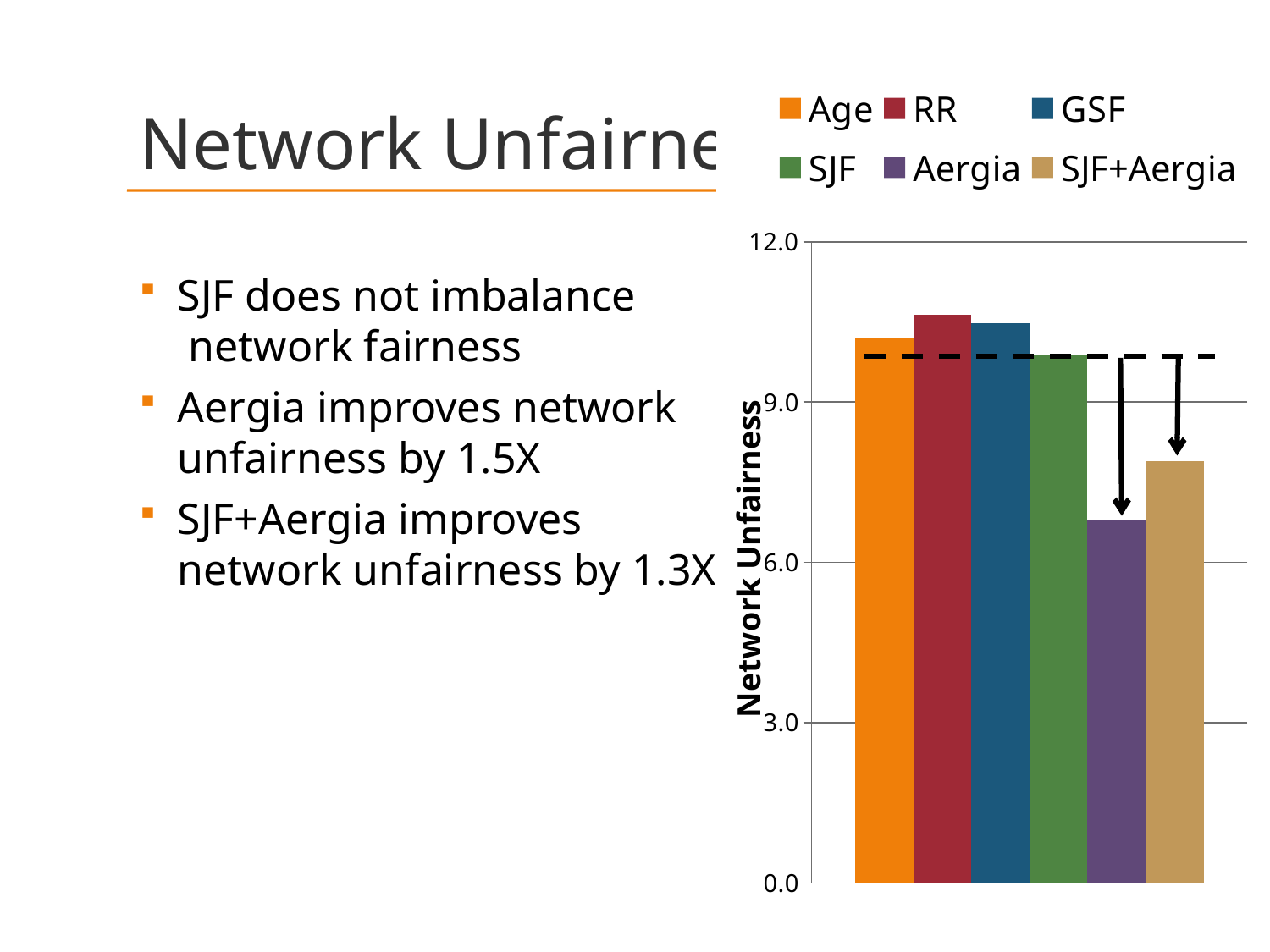
Which has a higher Network Unfairness value, Age or Aergia? Age What kind of chart is shown on the slide? bar chart Is the Network Unfairness value for Age greater or less than 9.0? greater What colour represents Aergia in the chart's legend? purple Which series has the lowest Network Unfairness value? Aergia Is the Network Unfairness value for Aergia greater or less than 9.0? less Is the Network Unfairness value for SJF+Aergia greater or less than 9.0? less Which has a higher Network Unfairness value, SJF or SJF+Aergia? SJF How many series does the chart's legend list? 6 What is the title of the chart's vertical axis? Network Unfairness